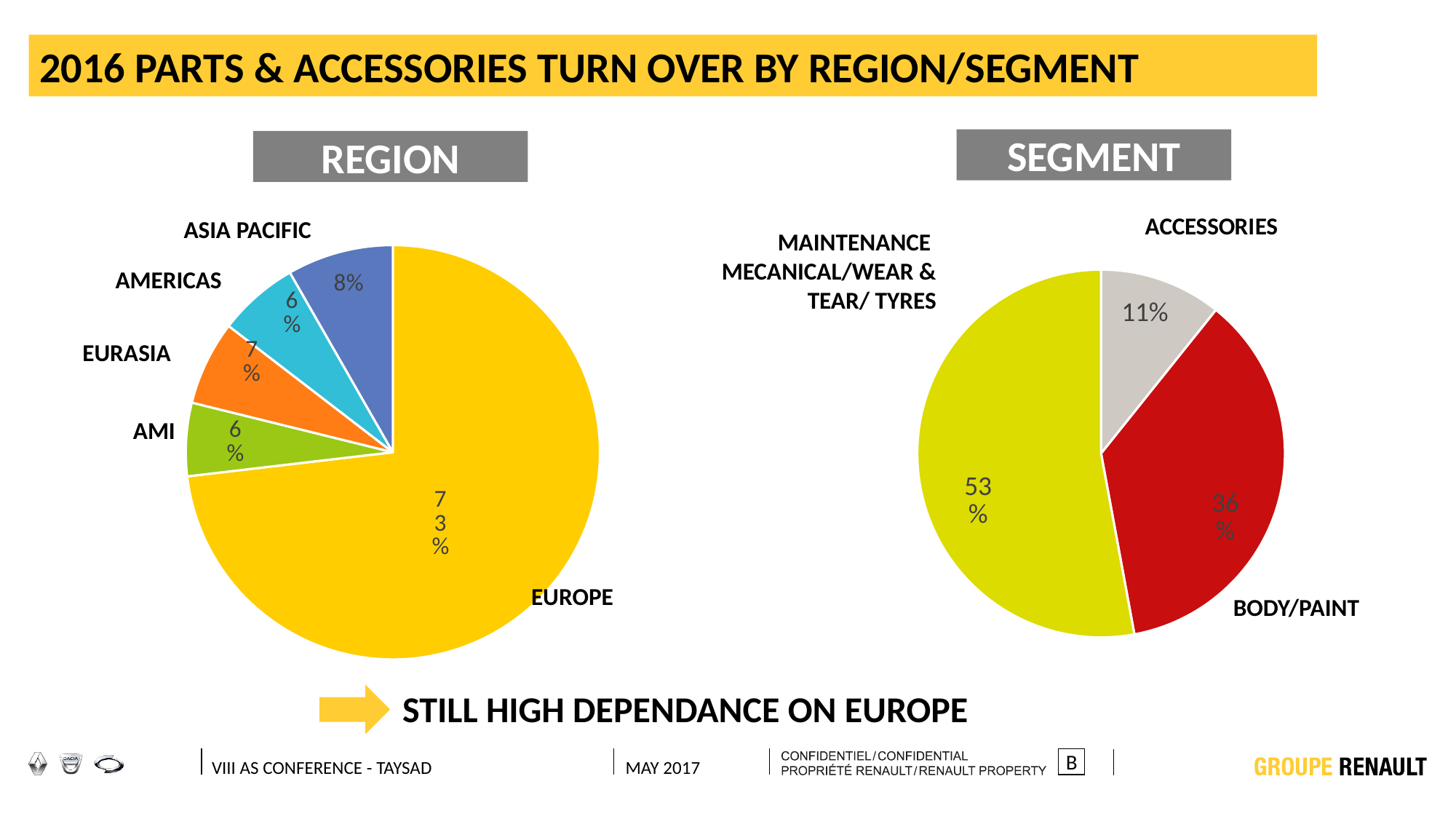
In the REGION pie chart, what share of turnover does EUROPE account for? 73% In the REGION pie chart, what is the value for EURASIA? 7% In the REGION pie chart, which is larger, EURASIA or AMERICAS? EURASIA In the SEGMENT pie chart, which segment has the smallest share? ACCESSORIES In the SEGMENT pie chart, what is the value for ACCESSORIES? 11% In the REGION pie chart, what is the difference between the EUROPE share and the ASIA PACIFIC share? 65% In the REGION pie chart, how many regions are shown? 5 In the SEGMENT pie chart, what is the difference between the MAINTENANCE MECANICAL/WEAR & TEAR/ TYRES share and the BODY/PAINT share? 17% In the REGION pie chart, what is the value for ASIA PACIFIC? 8% In the REGION pie chart, which region has the largest share? EUROPE In the SEGMENT pie chart, what is the value for BODY/PAINT? 36% What type of chart is used for the SEGMENT breakdown? Pie chart